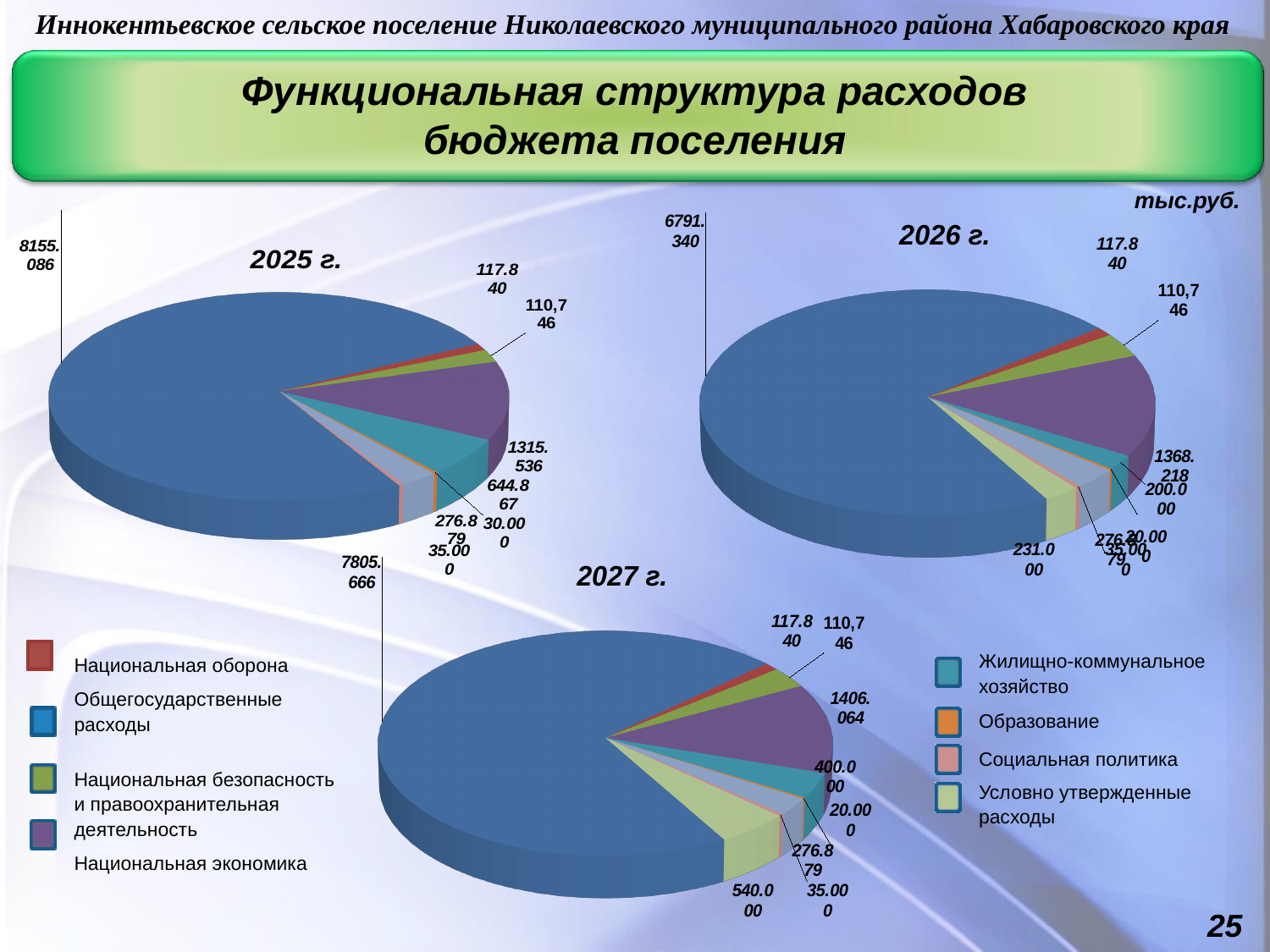
In the 2027 г. pie chart, what is the value of the largest slice (Общегосударственные расходы)? 7805.666 Which category has the largest slice in the 2025 г. pie chart? Общегосударственные расходы Which is larger: the Общегосударственные расходы value in the 2025 г. chart or in the 2027 г. chart? 2025 г. In the 2027 г. pie chart, what is the value of the Национальная экономика (purple) slice? 1406.064 How many pie charts are shown on the slide? 3 What unit of measurement is indicated for the values in the pie charts? тыс.руб. In the 2026 г. pie chart, what is the value of the Национальная экономика (purple) slice? 1368.218 In the 2025 г. pie chart, what is the value of the largest slice (Общегосударственные расходы)? 8155.086 How many categories does the legend list across the three pie charts? 8 What is the difference between the Жилищно-коммунальное хозяйство value in the 2027 г. chart (400.000) and in the 2026 г. chart (200.000)? 200.000 In the 2026 г. pie chart, what is the value of the largest slice (Общегосударственные расходы)? 6791.340 What kind of chart is used on this slide to show the functional structure of expenditures? pie chart